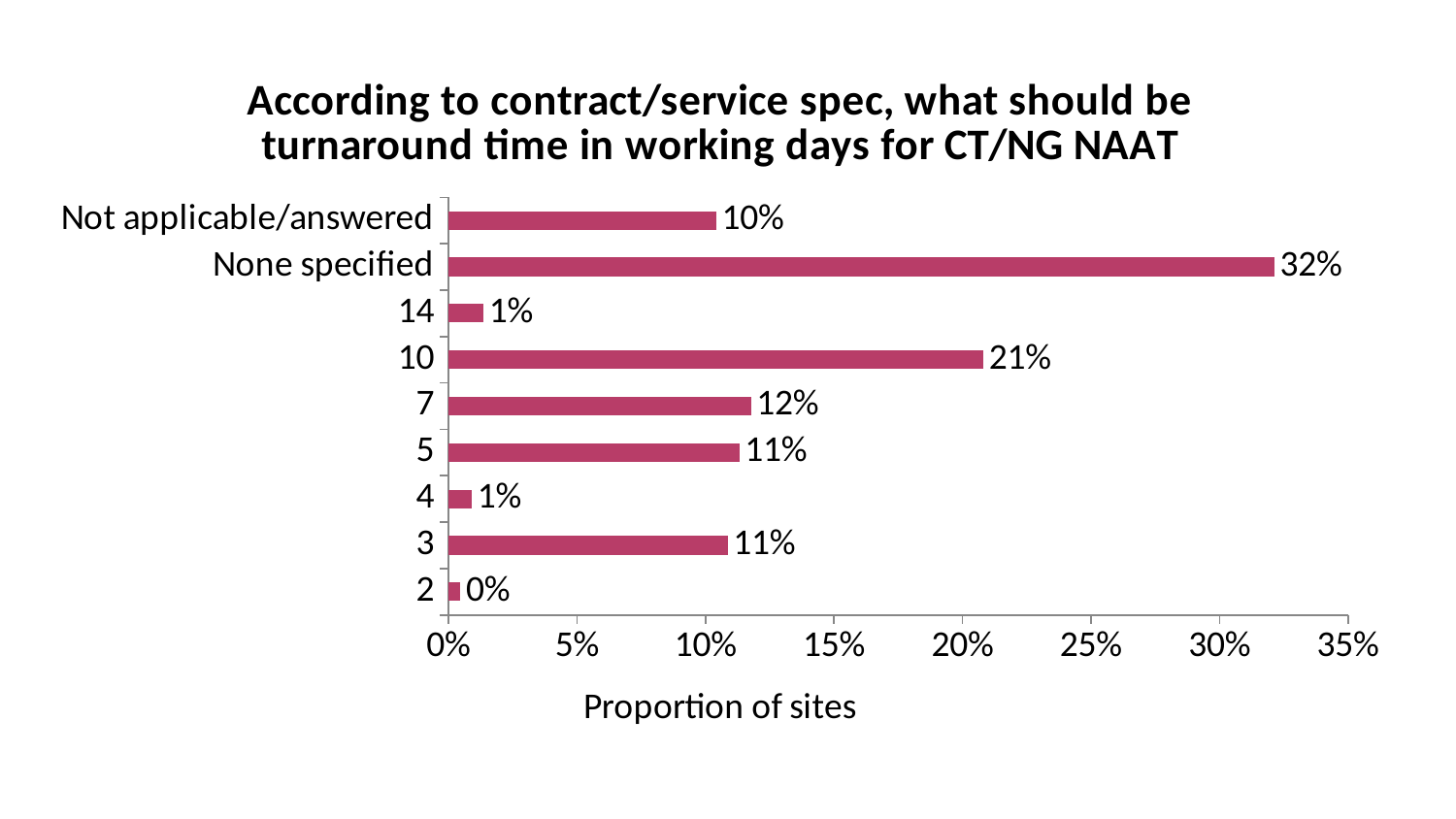
What proportion of sites reported a turnaround time of 10 working days? 21% Which category has the highest proportion of sites? None specified Is the value for 'None specified' greater or less than 30%? greater How many categories are shown on the chart? 9 What is the difference in proportion of sites between 'None specified' and 10 working days? 11% What is the label of the horizontal axis? Proportion of sites What proportion of sites fall under 'Not applicable/answered'? 10% What kind of chart is shown on the slide? Bar chart Which has a larger proportion of sites: a turnaround time of 7 days or 5 days? 7 What proportion of sites reported 'None specified' for the turnaround time? 32% Which category has the lowest proportion of sites? 2 What proportion of sites reported a turnaround time of 7 working days? 12%